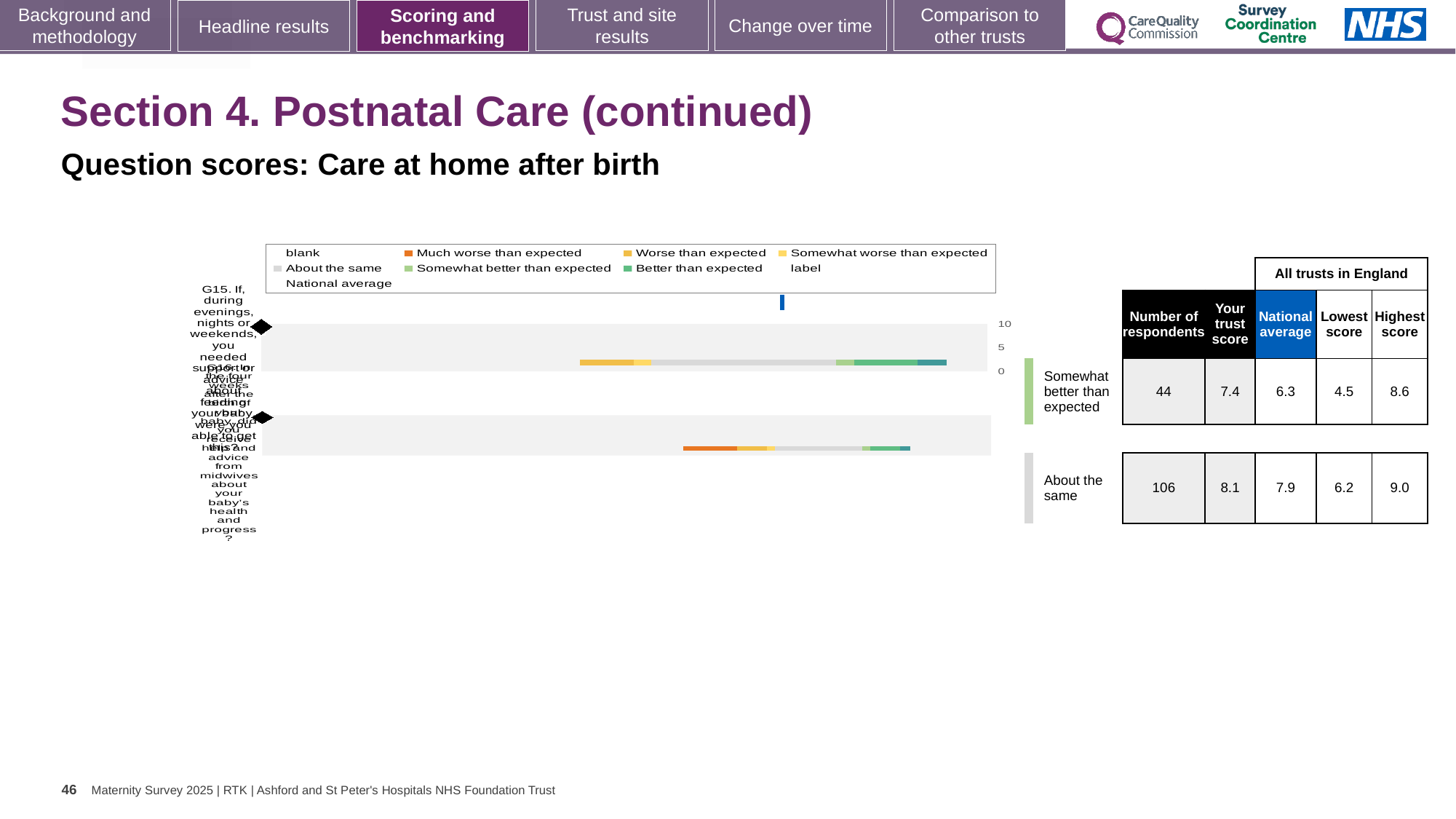
What is the highest score among all trusts in England for the question rated 'About the same'? 9.0 What is the difference between the trust score and the national average for the question rated 'About the same'? 0.2 How many respondents answered the question rated 'Somewhat better than expected'? 44 Which of the two questions has the higher trust score? The one rated 'About the same' (8.1) What is the trust score for the question rated 'About the same'? 8.1 What kind of chart is shown on the slide? Bar chart Which benchmark category is the top bar (G15) rated as? Somewhat better than expected How many question bars are plotted in the chart? 2 What is the highest tick value shown on the chart's score axis? 10 What is the difference between the highest and lowest scores for the question rated 'Somewhat better than expected'? 4.1 What is the national average for the question rated 'Somewhat better than expected'? 6.3 For the question rated 'Somewhat better than expected', which is larger: the trust score or the national average? Trust score